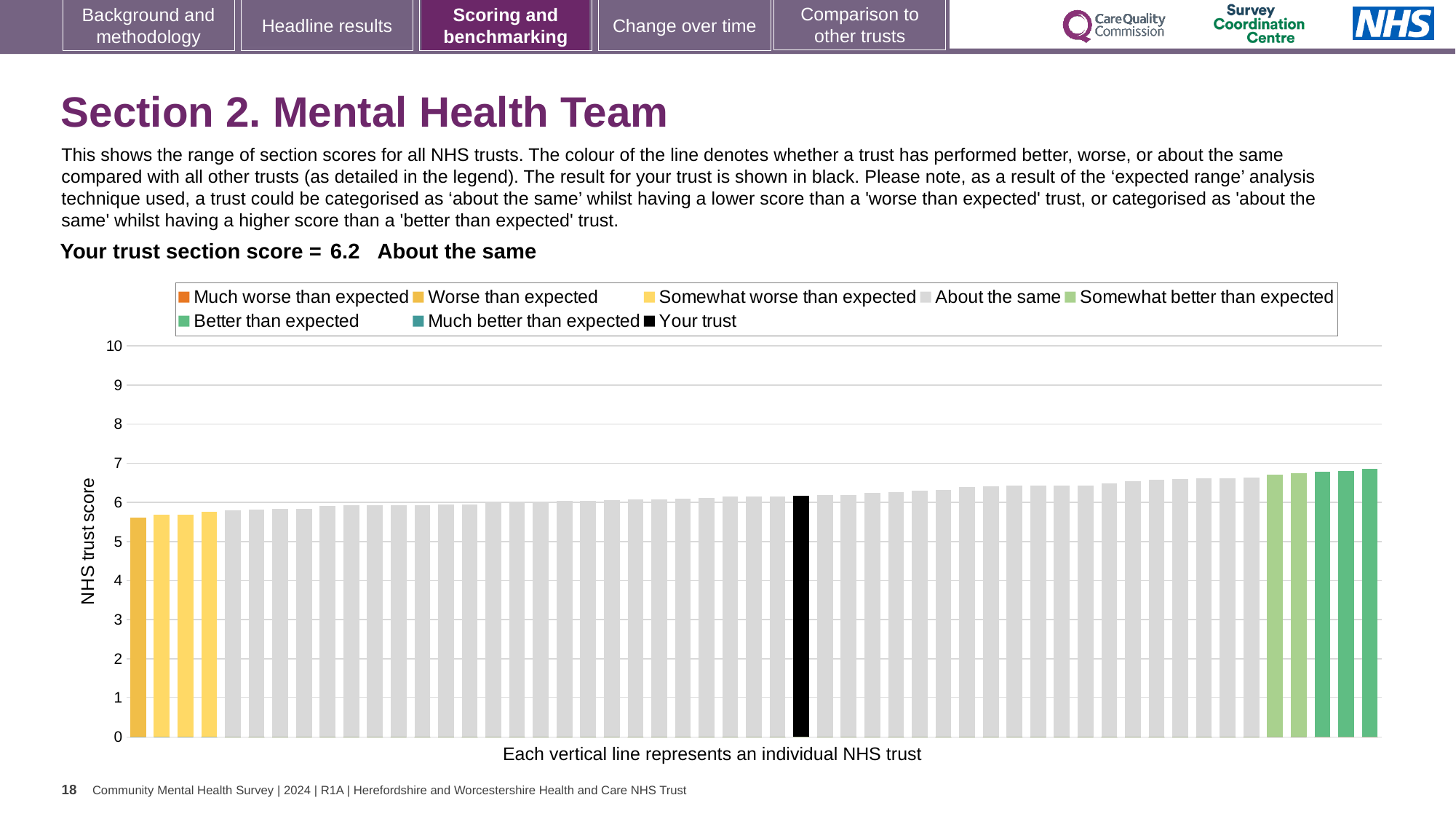
Is the value of the leftmost bar greater or less than 6? less Which performance category is your trust placed in for this section? About the same Is the value of the rightmost bar greater or less than 6? greater What is the section score for your trust shown on the slide? 6.2 What kind of chart is shown on the slide? bar chart What is the label on the vertical axis of the chart? NHS trust score Is the value of the black bar (your trust) greater or less than 6? greater What colour is the bar representing your trust? black How many entries does the chart legend list? 8 Do the bar values rise or fall from left to right along the x axis? rise